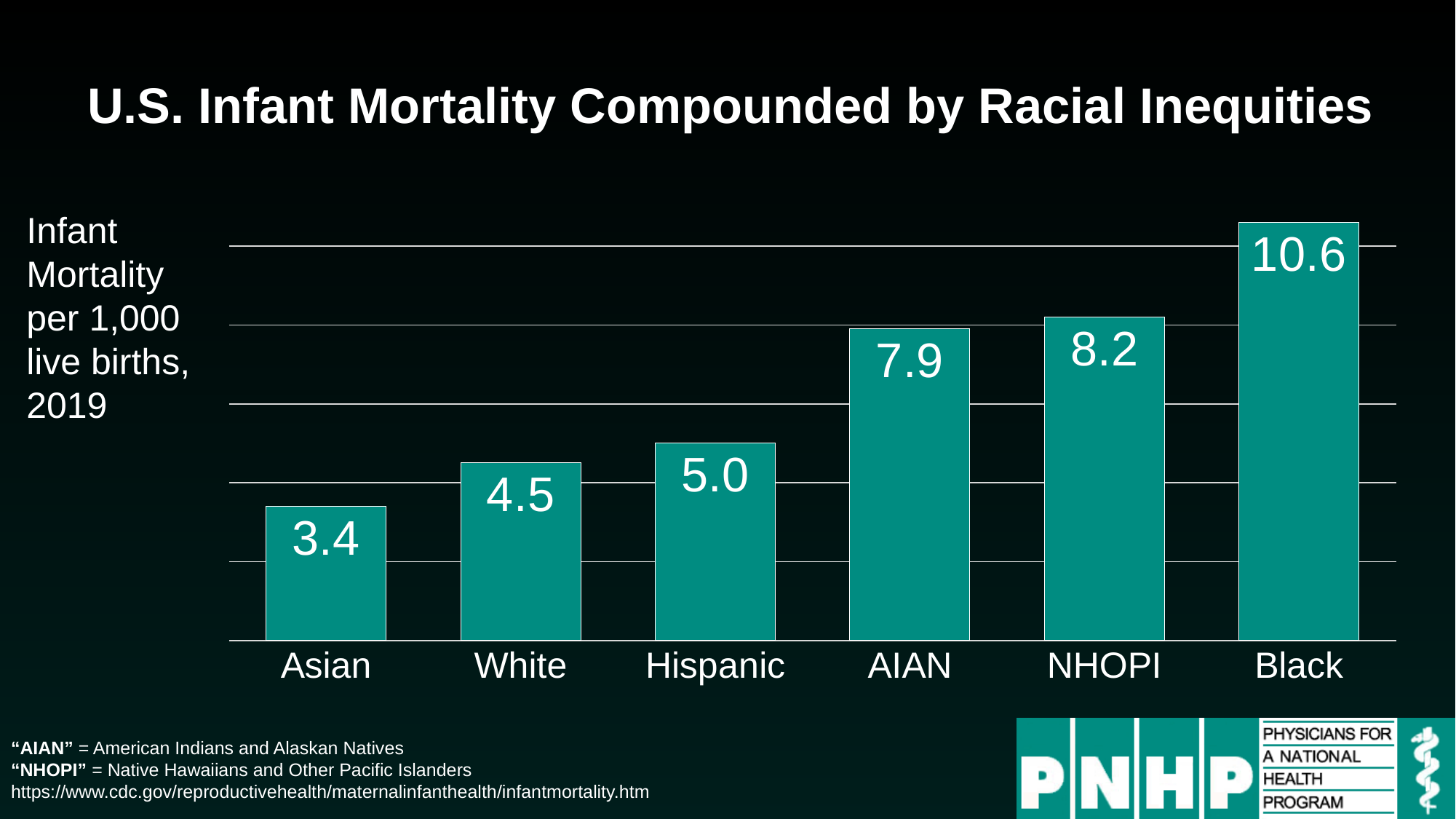
What is the infant mortality rate per 1,000 live births for Black infants? 10.6 Do the infant mortality values rise or fall from left to right across the groups? Rise Which group has a higher infant mortality rate, NHOPI or AIAN? NHOPI What is the infant mortality rate per 1,000 live births for NHOPI infants? 8.2 Which group has the lowest infant mortality rate? Asian What is the infant mortality rate per 1,000 live births for Asian infants? 3.4 What type of chart is shown on the slide? Bar chart What is the difference between the infant mortality rates for AIAN and Hispanic infants? 2.9 What is the difference between the infant mortality rates for Black and White infants? 6.1 What is the infant mortality rate per 1,000 live births for Hispanic infants? 5.0 Which group has the highest infant mortality rate? Black How many racial/ethnic groups are shown in the chart? 6